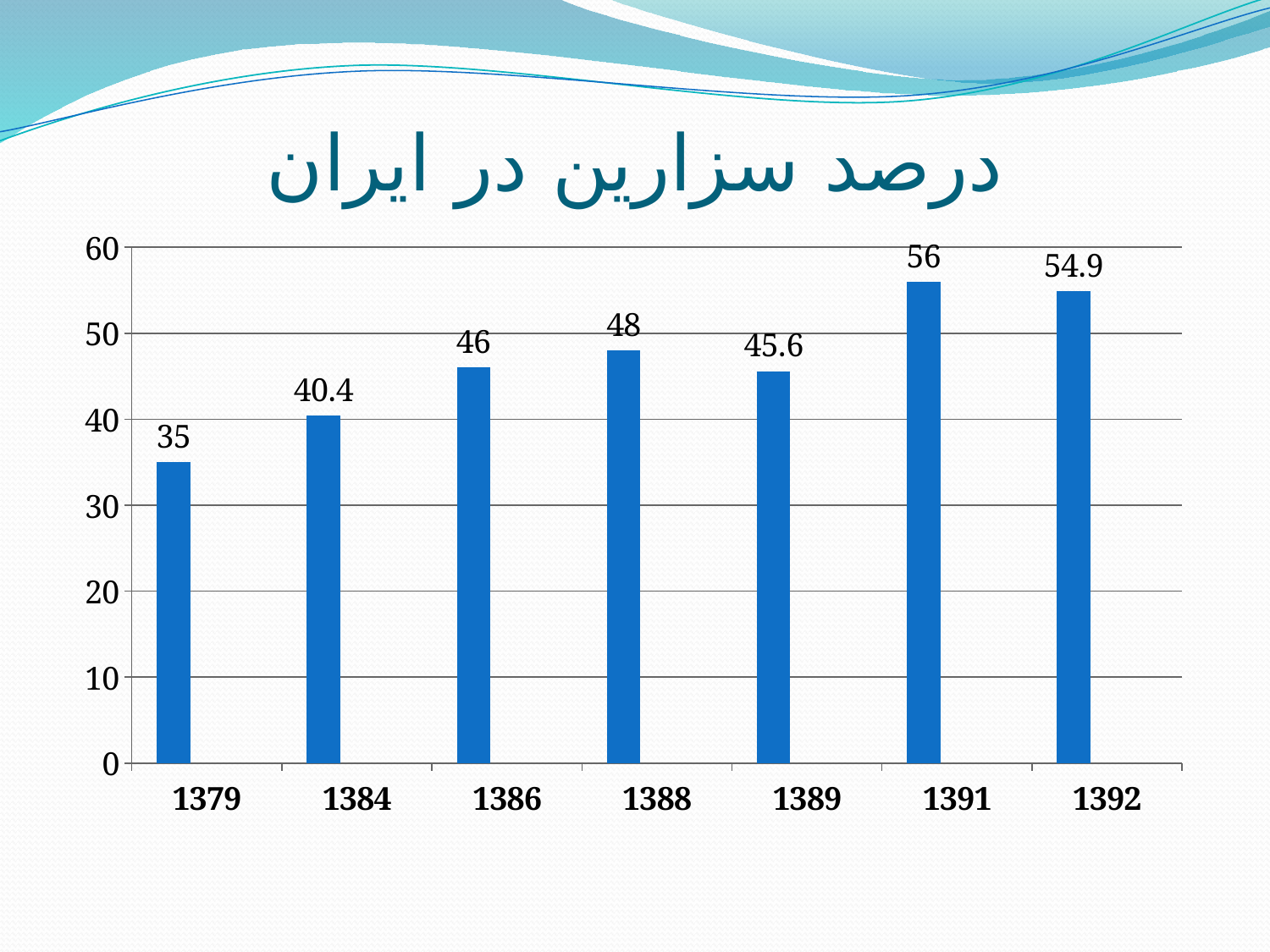
Which is larger, the value for 1386 or the value for 1384? 1386 Which year has the lowest value? 1379 What is the difference between the values for 1388 and 1389? 2.4 What is the value for 1389? 45.6 Is the value for 1388 greater or less than 40? greater What kind of chart is this? bar chart What is the value for 1379? 35 How many years are shown on the x axis? 7 What is the difference between the values for 1391 and 1379? 21 Which year has the highest value? 1391 What is the title of the chart? درصد سزارین در ایران What is the value for 1392? 54.9